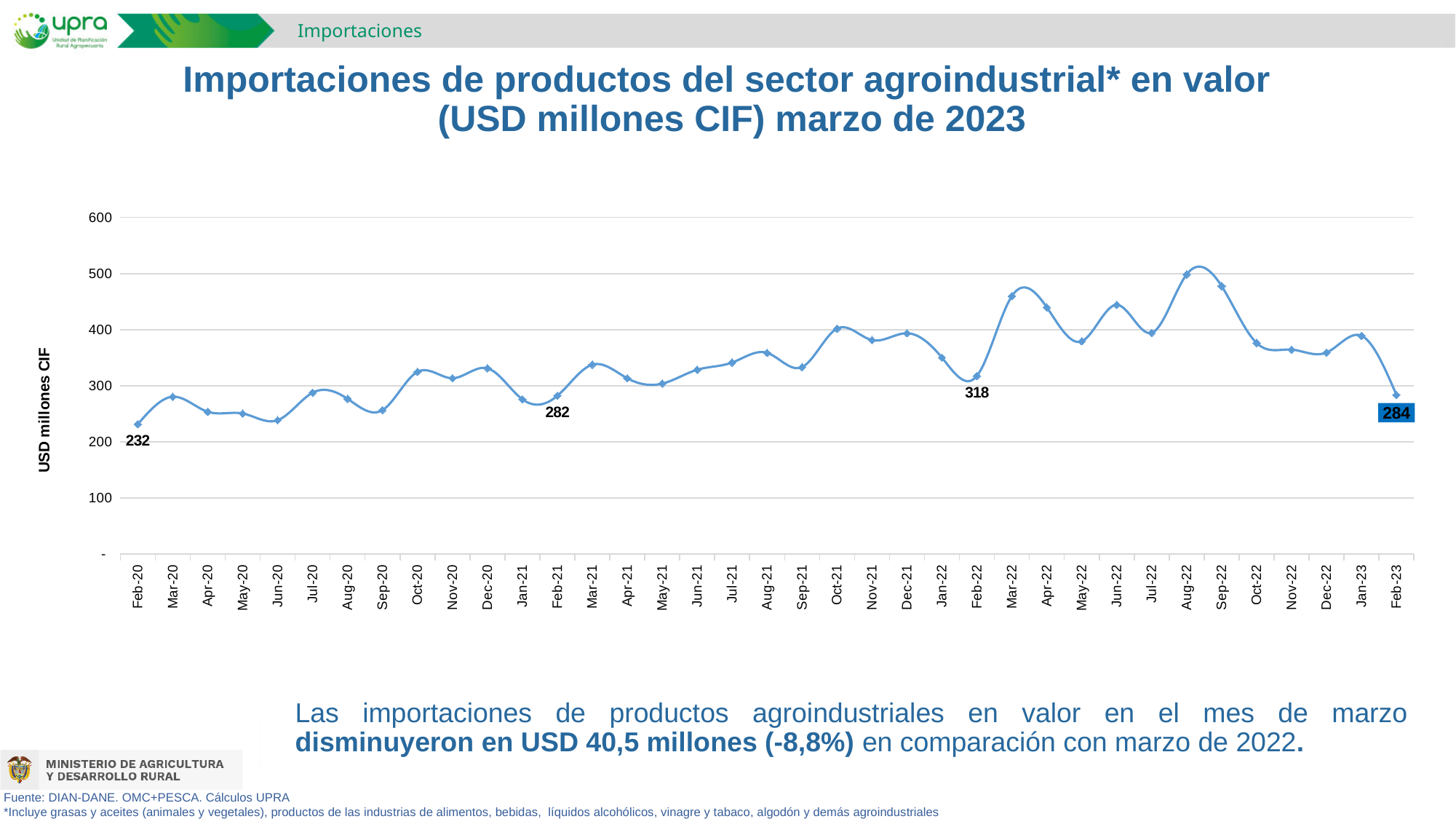
Which month has the highest value on the chart? Aug-22 What is the value for Feb-22? 318 Is the value for Mar-22 greater or less than 400? greater What is the difference between the values for Feb-22 and Feb-21? 36 What is the value for Feb-20? 232 Is the value for Jun-20 greater or less than 300? less What is the label of the vertical axis? USD millones CIF What is the value for Feb-23? 284 What kind of chart is shown on the slide? line chart What is the difference between the values for Feb-23 and Feb-20? 52 Which is larger, the value for Feb-22 or the value for Feb-23? Feb-22 What is the value for Feb-21? 282